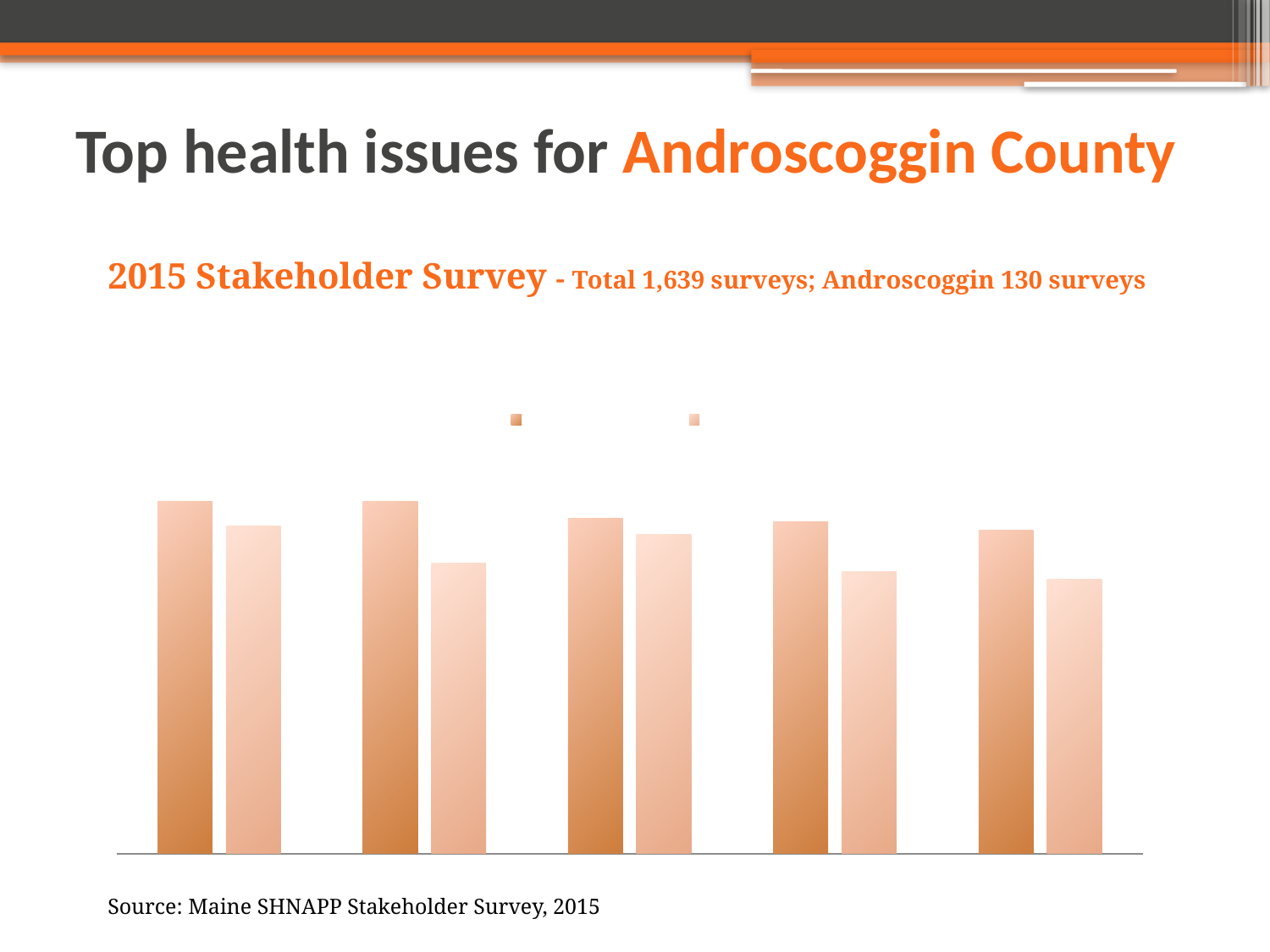
In the leftmost group of bars, is the darker orange bar or the lighter orange bar taller? the darker orange bar How many series does the chart's legend show? 2 In the second group of bars from the left, is the darker orange bar or the lighter orange bar taller? the darker orange bar Across all five groups, which series is taller in every group: the darker orange series or the lighter orange series? the darker orange series What kind of chart is shown on the slide? bar chart How many groups of bars are plotted in the chart? 5 How many bars in total are plotted in the chart? 10